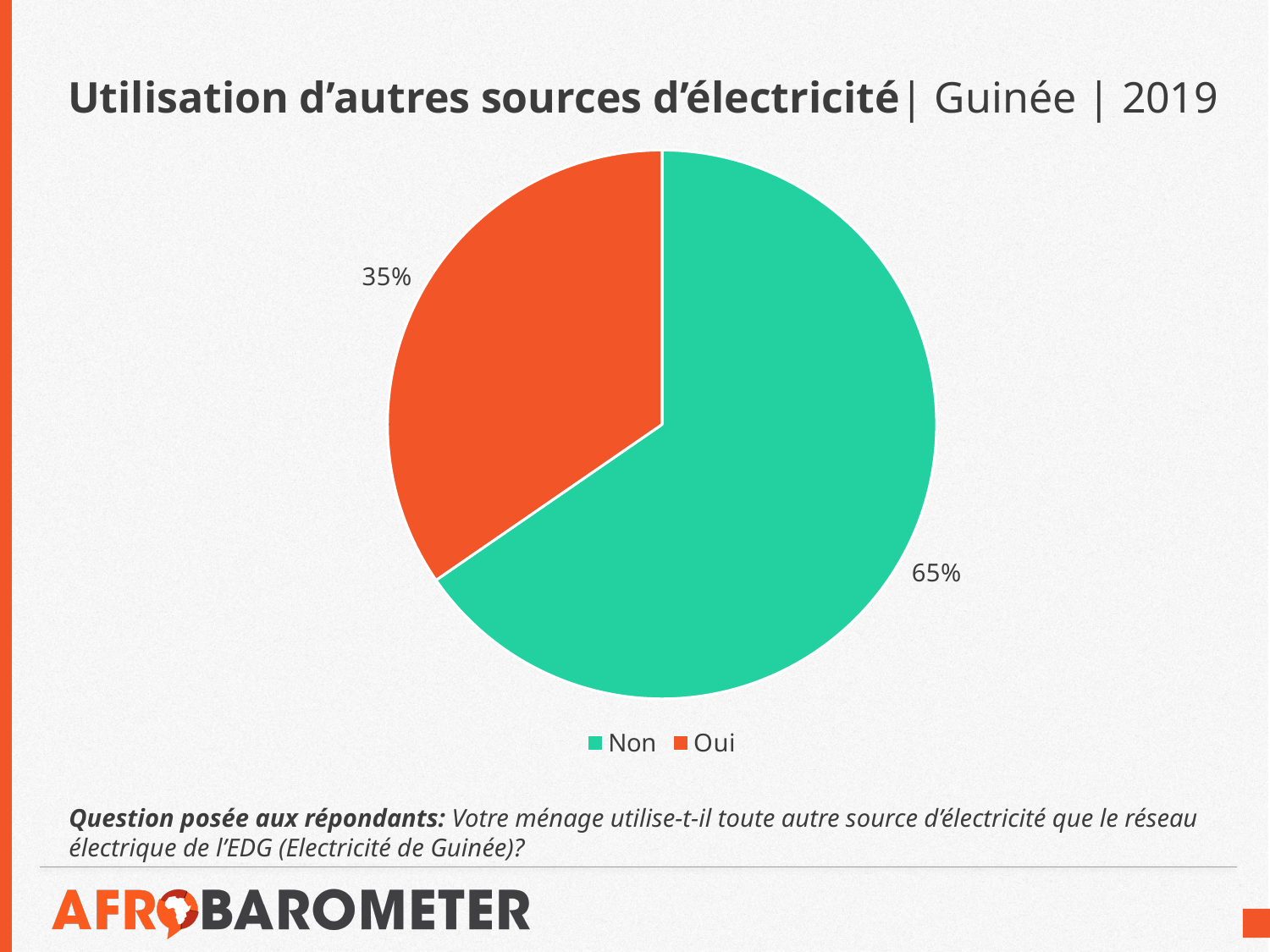
What percentage of respondents answered "Oui"? 35% Which country and year does the chart title refer to? Guinée, 2019 Which response has the smallest share of the pie? Oui How many slices does the pie chart have? 2 How many entries does the legend list? 2 What type of chart is shown on the slide? Pie chart What percentage of respondents answered "Non"? 65% What share of the pie does the "Oui" slice represent? 35% Which response has the largest share of the pie? Non Which is larger, the share for "Oui" or the share for "Non"? Non What is the difference in percentage points between the "Non" and "Oui" slices? 30 What colour is the "Non" slice? Green